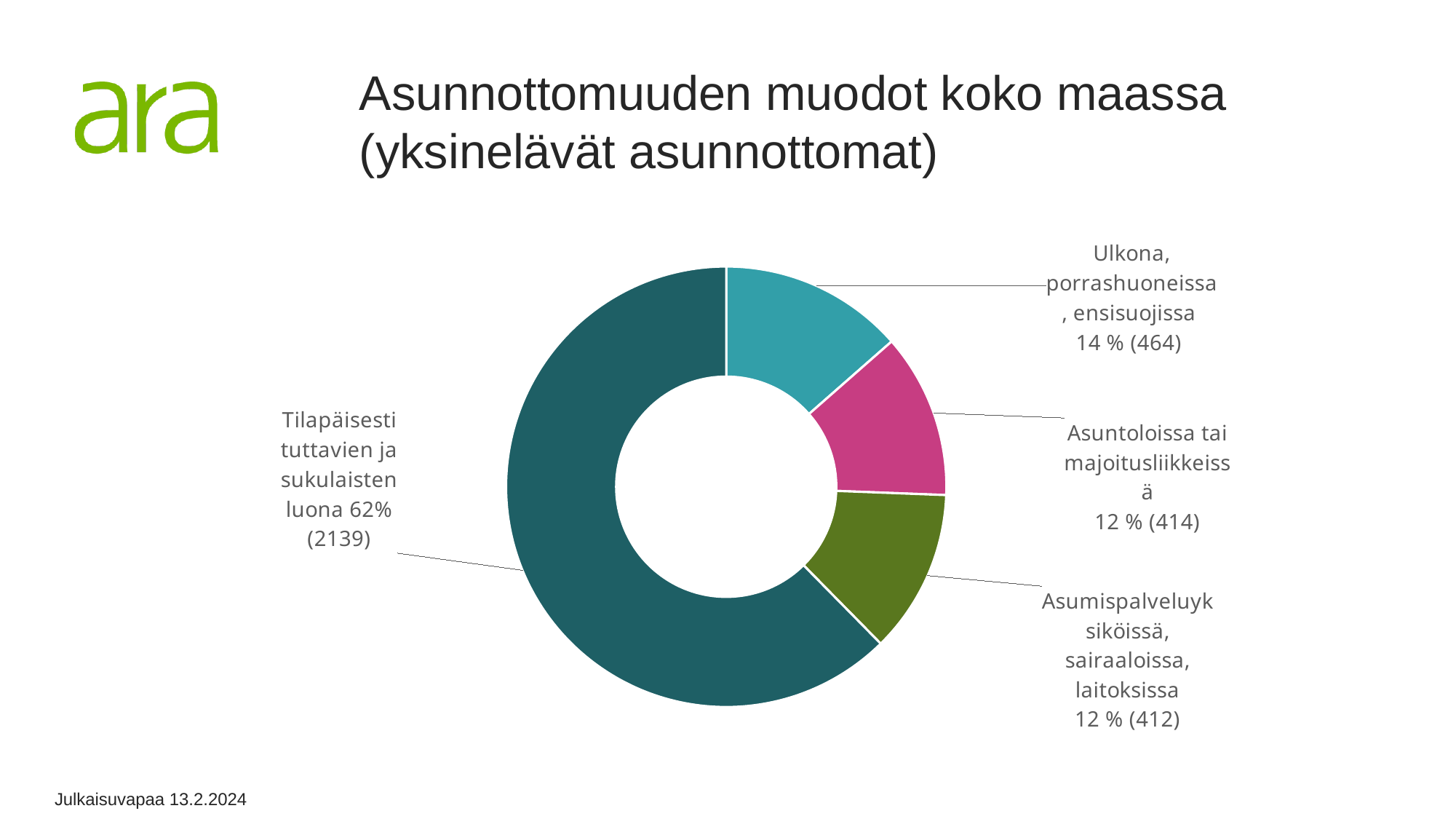
What is the count for 'Tilapäisesti tuttavien ja sukulaisten luona'? 2139 Which category has the largest share? Tilapäisesti tuttavien ja sukulaisten luona What is the title of the slide containing the chart? Asunnottomuuden muodot koko maassa (yksinelävät asunnottomat) Which has a larger count: 'Ulkona, porrashuoneissa, ensisuojissa' or 'Asuntoloissa tai majoitusliikkeissä'? Ulkona, porrashuoneissa, ensisuojissa What share of the chart is 'Asuntoloissa tai majoitusliikkeissä'? 12 % What kind of chart is shown on the slide? Pie chart (donut) What share of the chart is 'Tilapäisesti tuttavien ja sukulaisten luona'? 62% How many categories does the chart show? 4 Which category has the smallest count? Asumispalveluyksiköissä, sairaaloissa, laitoksissa What is the count for 'Ulkona, porrashuoneissa, ensisuojissa'? 464 What is the difference in count between 'Ulkona, porrashuoneissa, ensisuojissa' and 'Asuntoloissa tai majoitusliikkeissä'? 50 What is the count for 'Asumispalveluyksiköissä, sairaaloissa, laitoksissa'? 412